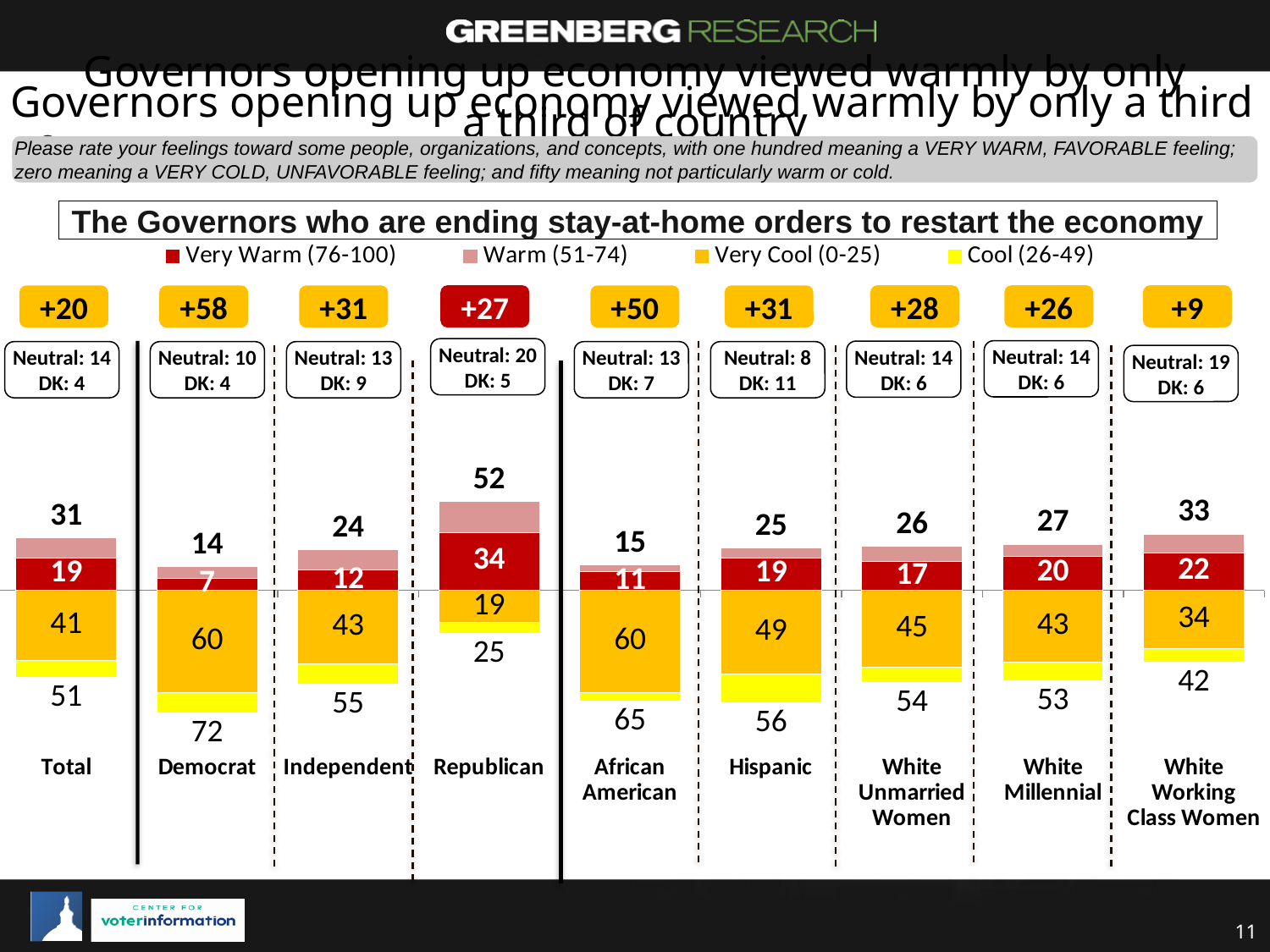
What is the Very Cool (0-25) value for Democrat? 60 Which has a larger Very Cool (0-25) value, Hispanic or White Millennial? Hispanic What kind of chart is shown on the slide? Stacked bar chart What is the title of the chart? The Governors who are ending stay-at-home orders to restart the economy What is the Neutral value shown above the Republican bar? 20 What is the difference between the Very Cool (0-25) value and the Very Warm (76-100) value for Total? 22 How many categories are shown along the x axis of the chart? 9 Which category has the lowest Very Warm (76-100) value? Democrat What is the Very Warm (76-100) value for White Working Class Women? 22 What is the Very Warm (76-100) value for Republican? 34 How many series does the chart legend list? 4 Which category has the highest Very Warm (76-100) value? Republican